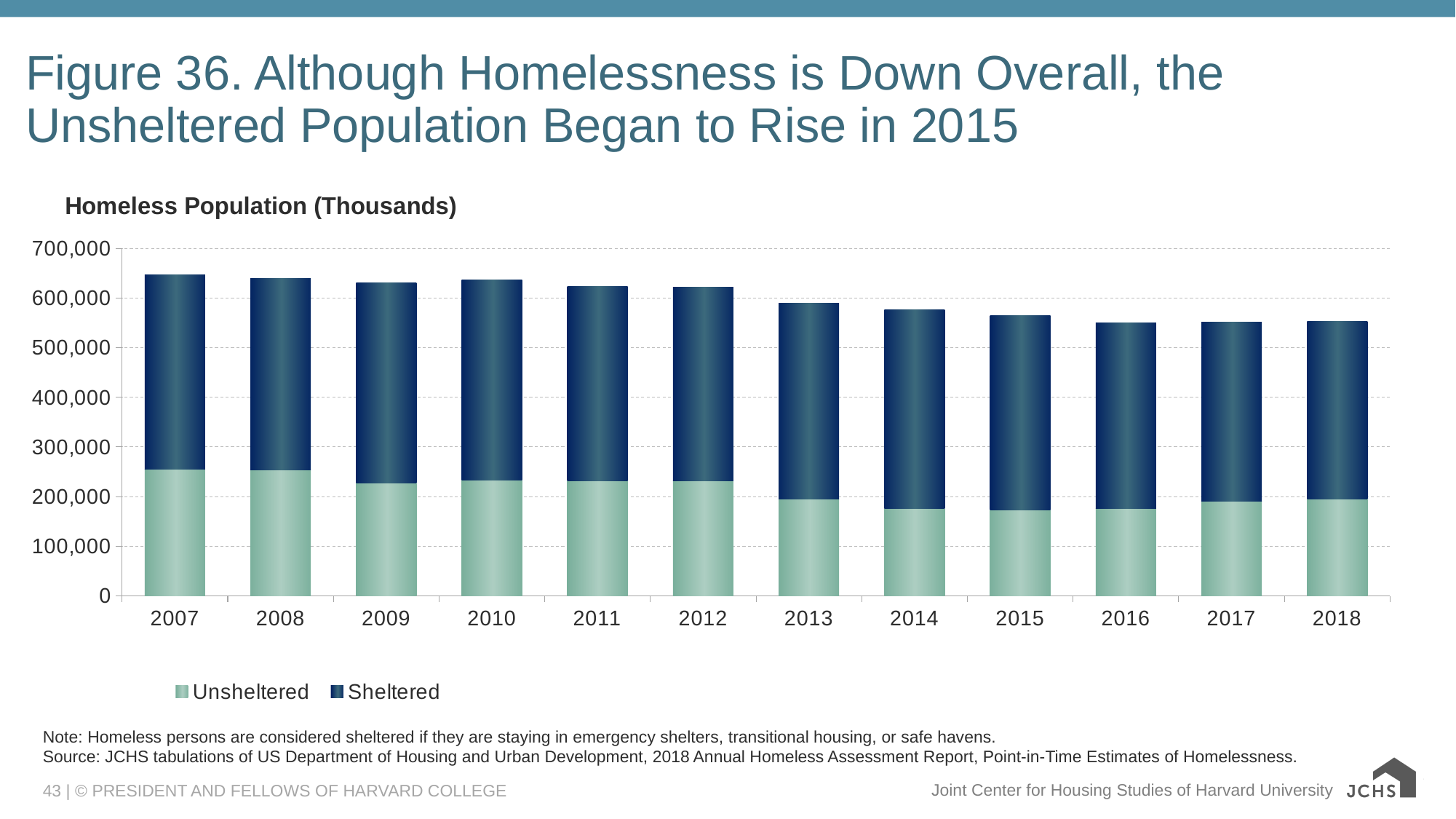
Is the Unsheltered value for 2015 greater or less than 200,000? less Is the total homeless population for 2018 greater or less than 600,000? less What kind of chart is shown on the slide? Stacked bar chart Which year has the larger Unsheltered value, 2007 or 2015? 2007 What is the label above the chart's vertical axis? Homeless Population (Thousands) Which year has the larger total homeless population, 2007 or 2018? 2007 Does the total homeless population generally rise or fall from 2007 to 2018? fall Which two series are listed in the chart's legend? Unsheltered and Sheltered How many years are shown along the x axis of the chart? 12 Is the total homeless population for 2007 greater or less than 600,000? greater How many series does the chart's legend list? 2